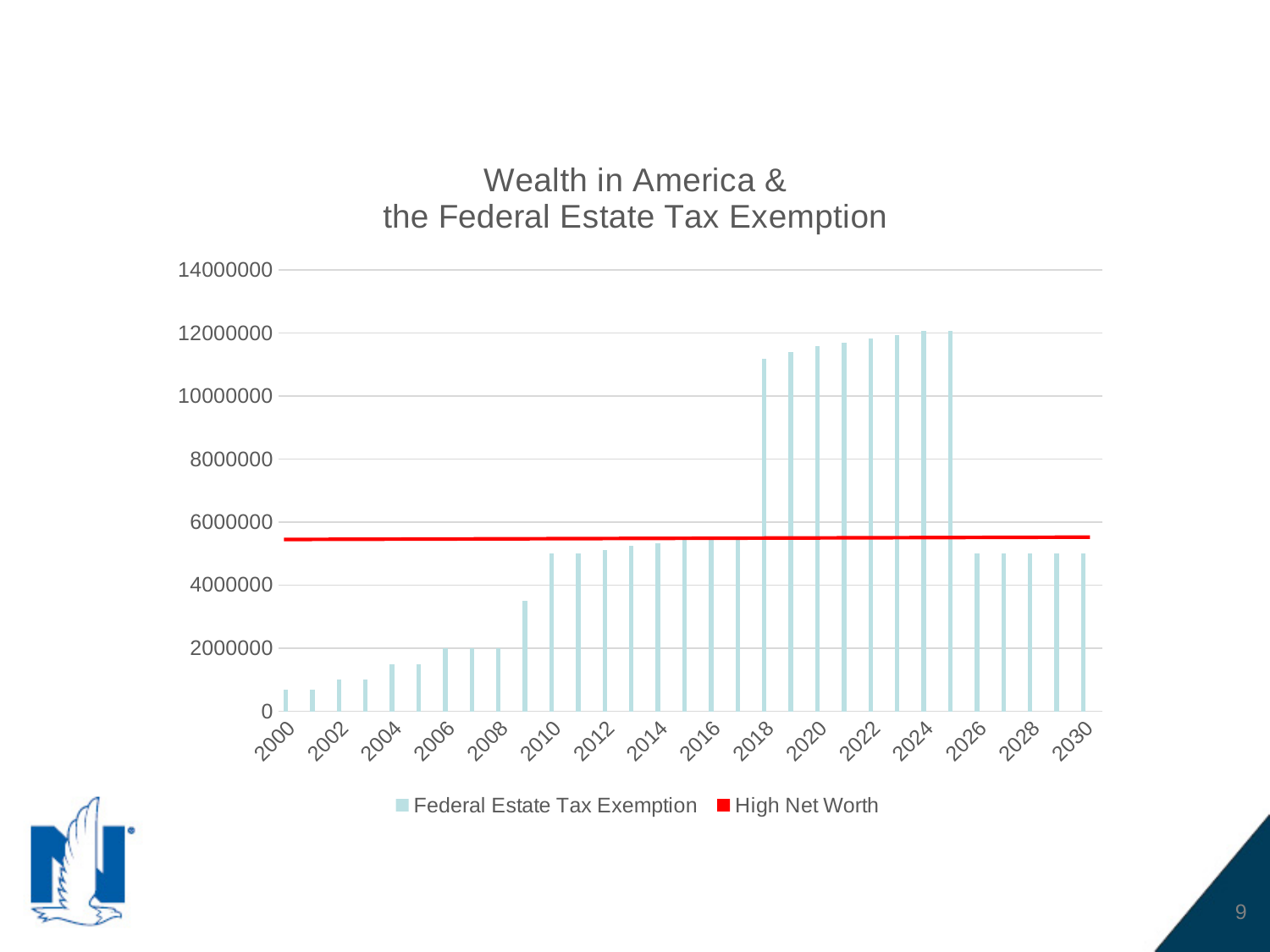
Which series is drawn as a red line? High Net Worth What kind of chart is shown on the slide? bar chart with a line How many series does the legend list? 2 Is the Federal Estate Tax Exemption value for 2018 greater or less than 10000000? greater What is the title of the chart? Wealth in America & the Federal Estate Tax Exemption Which year has the larger Federal Estate Tax Exemption, 2000 or 2010? 2010 Is the Federal Estate Tax Exemption value for 2010 greater or less than 4000000? greater Is the Federal Estate Tax Exemption value for 2026 greater or less than 4000000? greater Which year has the larger Federal Estate Tax Exemption, 2018 or 2026? 2018 Do the Federal Estate Tax Exemption bars rise or fall from 2000 to 2016? rise